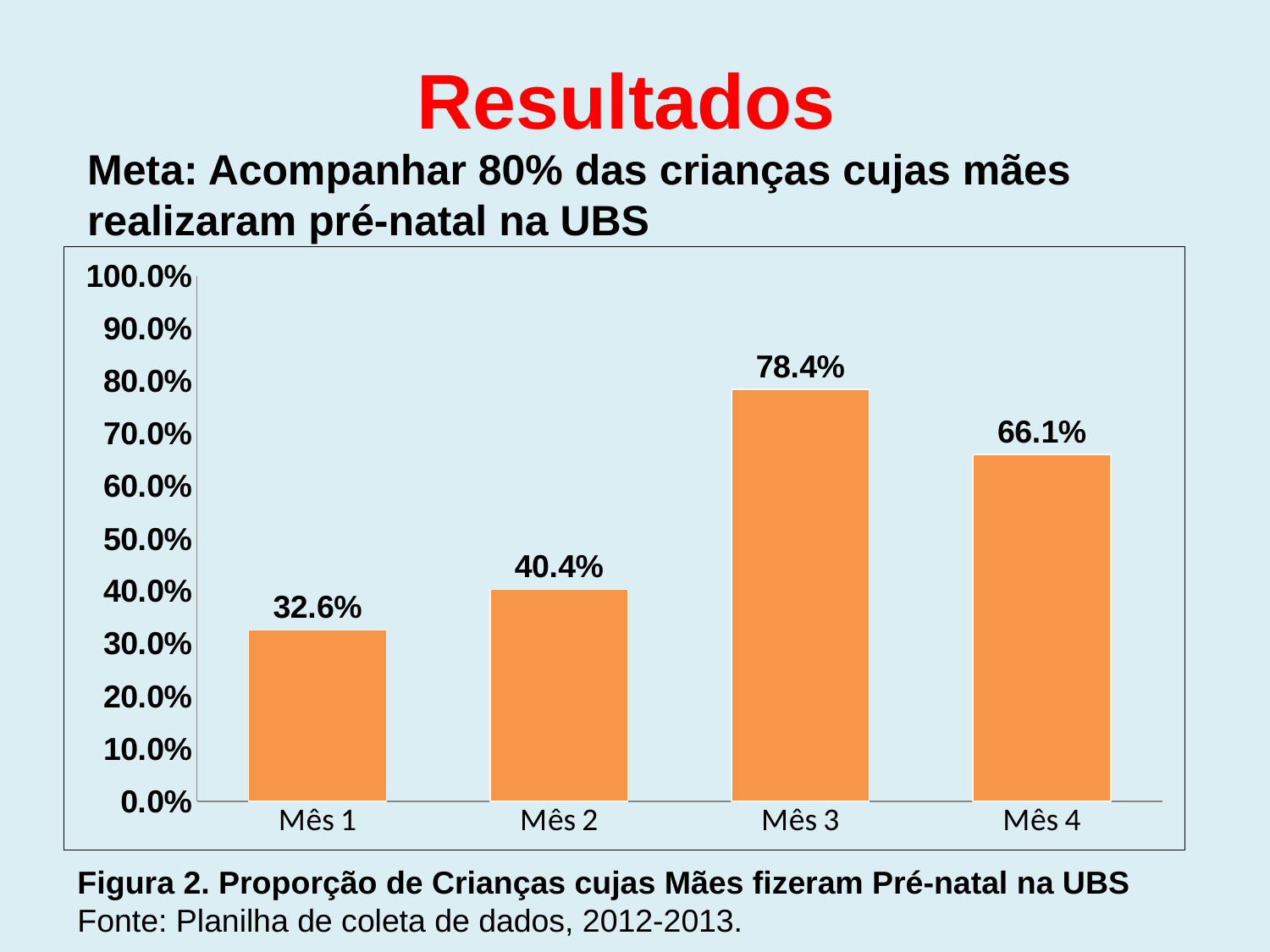
What kind of chart is shown on the slide? bar chart What is the value for Mês 4? 66.1% Which month has the highest value? Mês 3 Which is larger, the value for Mês 2 or the value for Mês 4? Mês 4 What is the value for Mês 3? 78.4% How many months are shown on the x axis? 4 Which month has the lowest value? Mês 1 What is the caption of the figure below the chart? Figura 2. Proporção de Crianças cujas Mães fizeram Pré-natal na UBS What is the value for Mês 1? 32.6% What is the difference between the values for Mês 2 and Mês 1? 7.8% Is the value for Mês 3 greater or less than 80.0%? less What is the difference between the values for Mês 3 and Mês 4? 12.3%